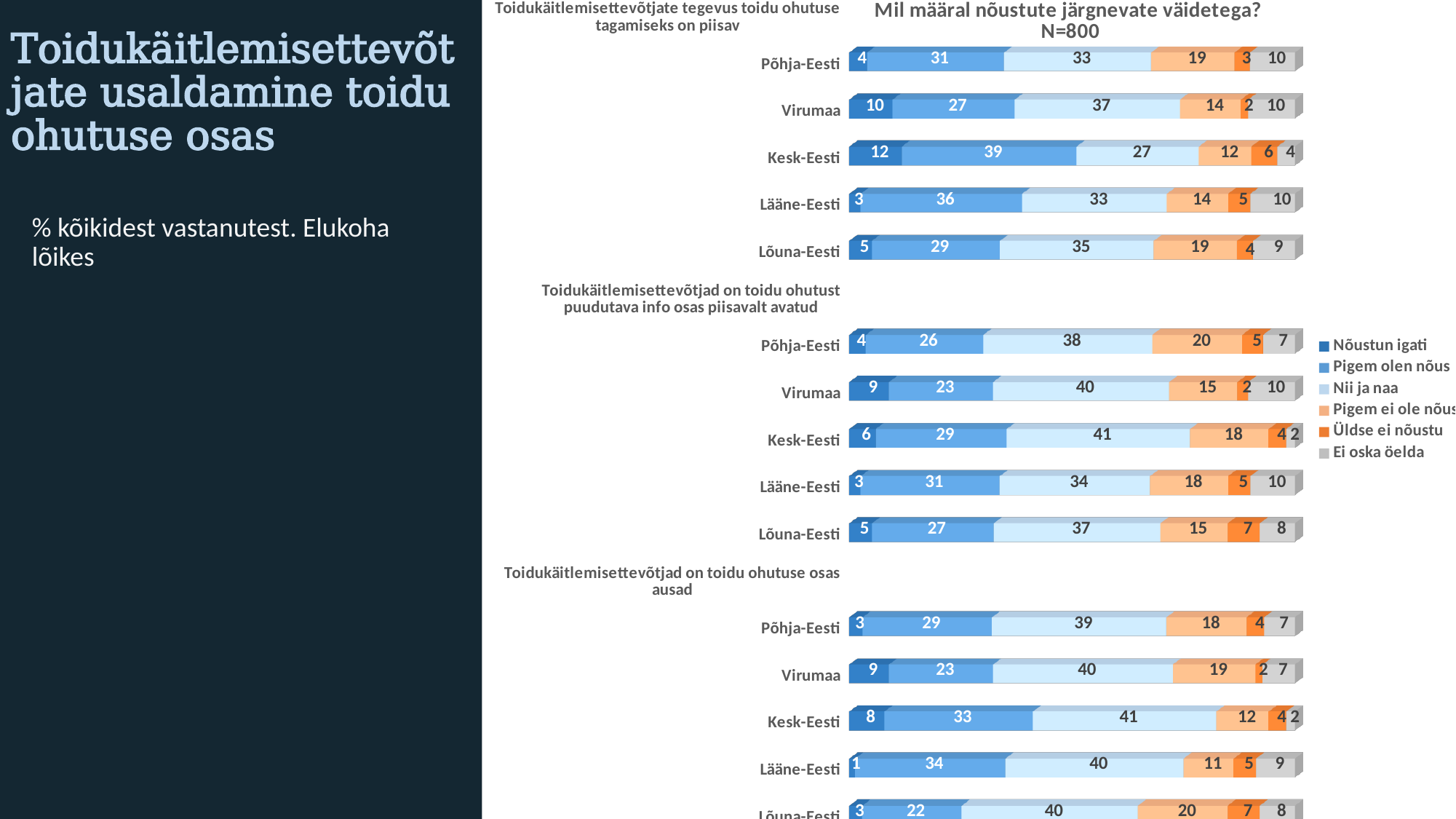
For the statement "Toidukäitlemisettevõtjate tegevus toidu ohutuse tagamiseks on piisav", what is the "Pigem olen nõus" value for Kesk-Eesti? 39 For the statement "Toidukäitlemisettevõtjad on toidu ohutuse osas ausad", what is the "Nõustun igati" value for Lääne-Eesti? 1 For the statement "Toidukäitlemisettevõtjad on toidu ohutust puudutava info osas piisavalt avatud", which region has the larger "Pigem olen nõus" value: Lääne-Eesti or Virumaa? Lääne-Eesti For the statement "Toidukäitlemisettevõtjate tegevus toidu ohutuse tagamiseks on piisav", what is the total of the Kesk-Eesti bar? 100 For the statement "Toidukäitlemisettevõtjad on toidu ohutuse osas ausad", what is the difference between the "Pigem ei ole nõus" values for Põhja-Eesti and Lääne-Eesti? 7 How many regions are shown for each statement in the chart? 5 For the statement "Toidukäitlemisettevõtjate tegevus toidu ohutuse tagamiseks on piisav", which region has the highest "Nõustun igati" value? Kesk-Eesti For the statement "Toidukäitlemisettevõtjate tegevus toidu ohutuse tagamiseks on piisav", what is the "Nii ja naa" value for Virumaa? 37 What kind of chart is shown on the slide? Stacked bar chart How many series does the legend list? 6 For the statement "Toidukäitlemisettevõtjad on toidu ohutust puudutava info osas piisavalt avatud", which region has the lowest "Ei oska öelda" value? Kesk-Eesti What sample size (N) is stated in the chart title? N=800